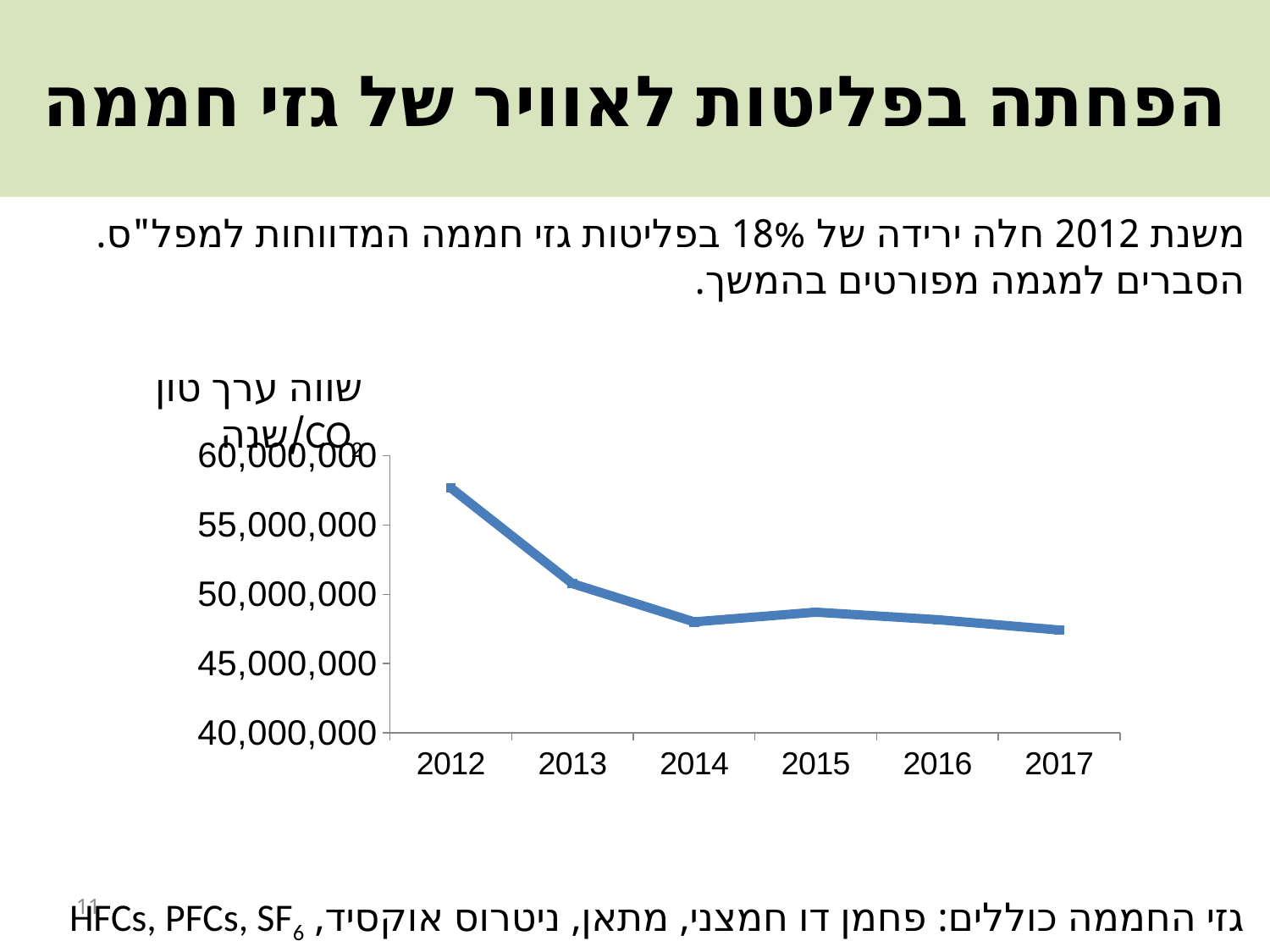
Which year has the larger value, 2013 or 2017? 2013 Is the value for 2017 greater or less than 50,000,000? less Do the values generally rise or fall from 2012 to 2017? fall Is the value for 2012 greater or less than 60,000,000? less Is the value for 2015 greater or less than 45,000,000? greater Which year has the larger value, 2012 or 2013? 2012 How many years are plotted along the x axis of the chart? 6 Which year has the highest value in the chart? 2012 What kind of chart is shown on the slide? line chart What is the first year shown on the x axis of the chart? 2012